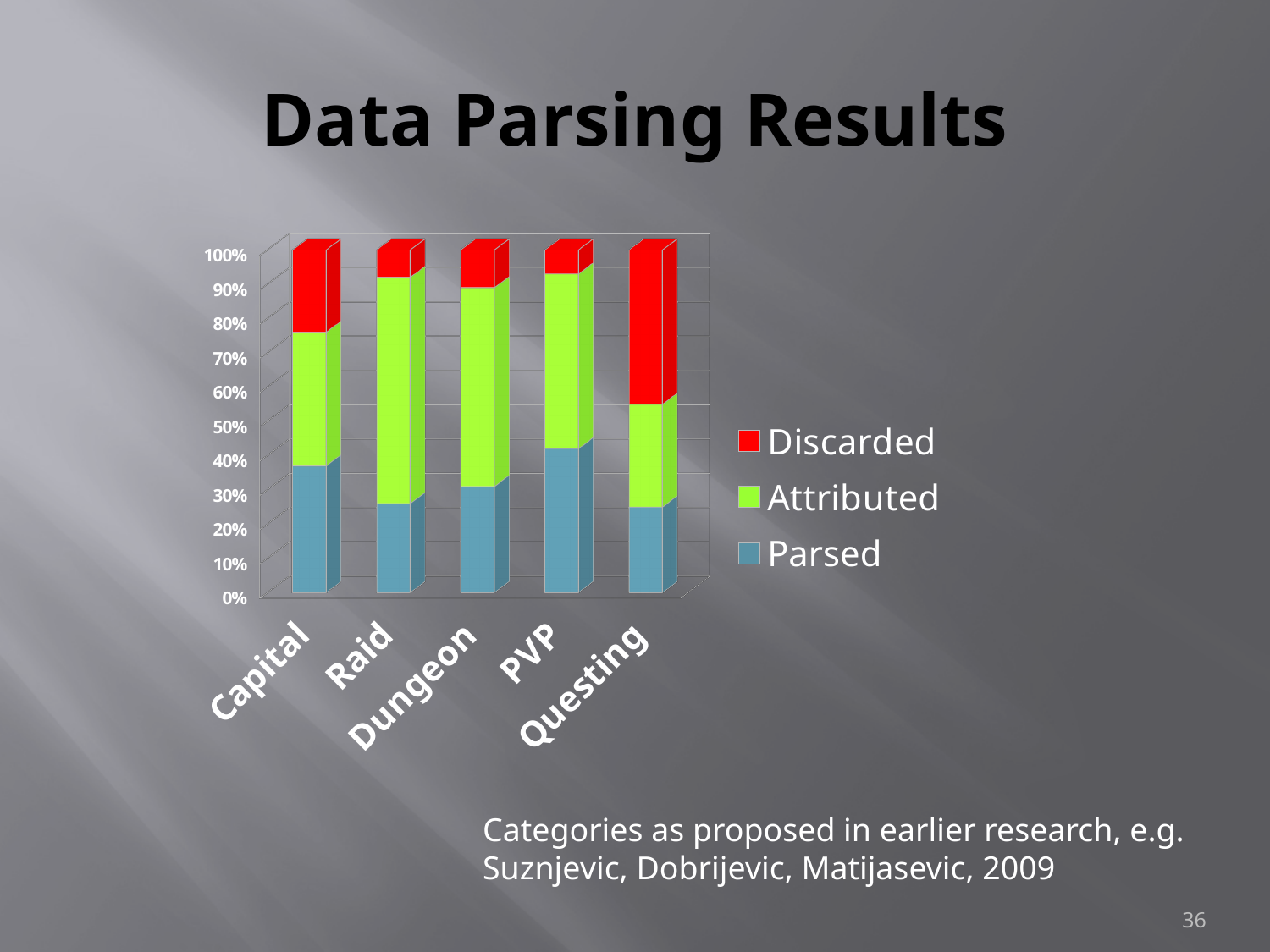
Which colour represents the Discarded series in the chart's legend? Red What is the title of the slide containing the chart? Data Parsing Results Is the Parsed share for Capital greater or less than 30%? greater Which category has the smallest Attributed share? Questing How many categories are shown on the x axis of the chart? 5 Is the Parsed share for Raid greater or less than 30%? less Which has the larger Discarded share, Questing or Capital? Questing Which has the larger Parsed share, PVP or Raid? PVP Is the Parsed share for PVP greater or less than 30%? greater What kind of chart is shown on the slide? Stacked bar chart Which category has the largest Discarded share? Questing How many series does the chart's legend list? 3